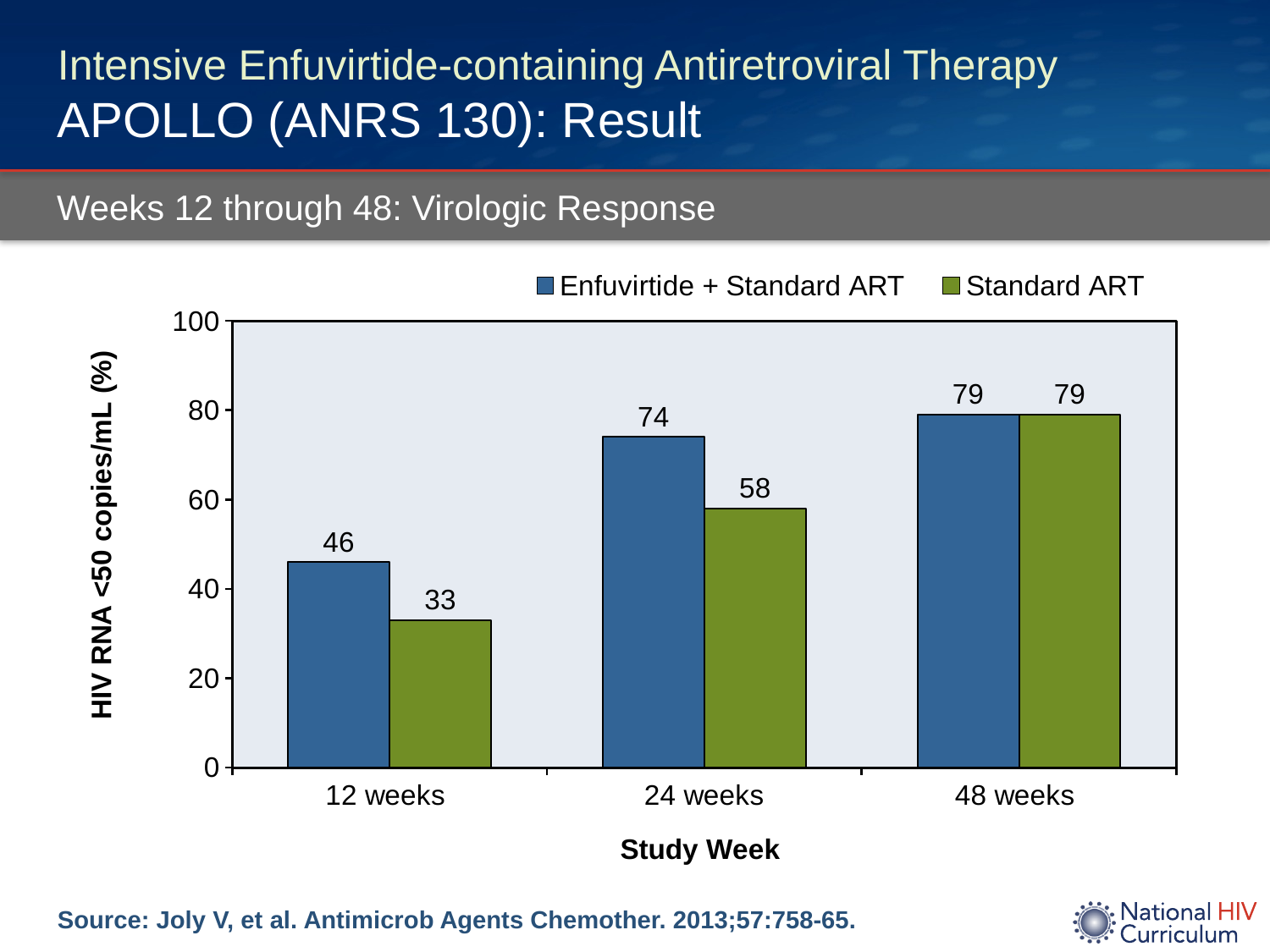
What is the value for Enfuvirtide + Standard ART at 12 weeks? 46 What is the value for Standard ART at 24 weeks? 58 What kind of chart is shown on the slide? Bar chart How many series does the legend list? 2 At which study week is the Enfuvirtide + Standard ART value highest? 48 weeks At which study week is the Standard ART value lowest? 12 weeks What is the difference between Enfuvirtide + Standard ART and Standard ART at 12 weeks? 13 How many study week categories are shown on the x axis? 3 What is the value for Standard ART at 48 weeks? 79 What is the difference between Enfuvirtide + Standard ART and Standard ART at 24 weeks? 16 Which is larger at 12 weeks: Enfuvirtide + Standard ART or Standard ART? Enfuvirtide + Standard ART Do the Standard ART values rise or fall from 12 weeks to 48 weeks? Rise